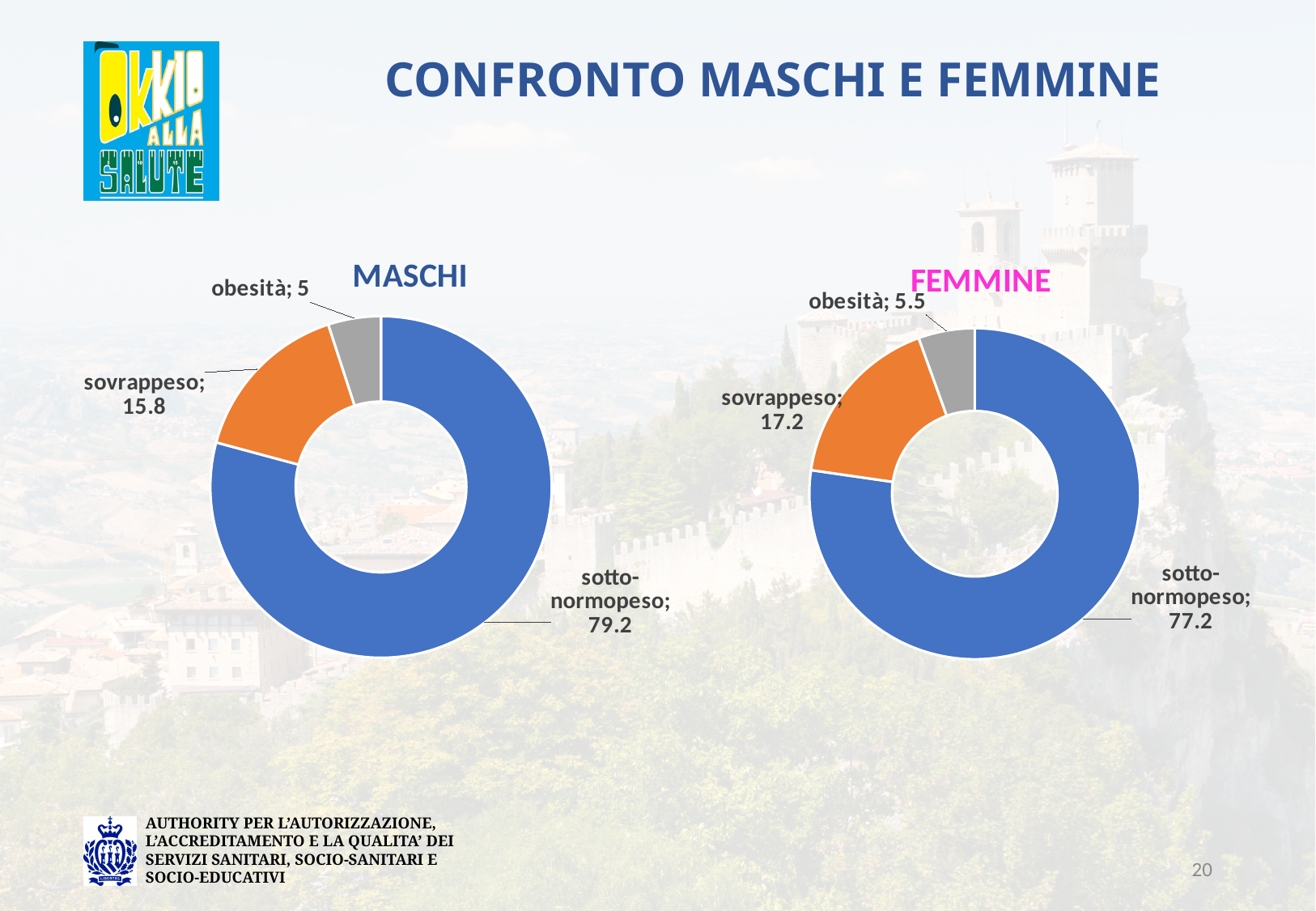
Which is larger: sotto-normopeso in the MASCHI chart or sotto-normopeso in the FEMMINE chart? MASCHI What is the difference between the sovrappeso values in the FEMMINE chart and the MASCHI chart? 1.4 In the FEMMINE chart, what is the value for sovrappeso? 17.2 In the MASCHI chart, which category has the smallest value? obesità What is the title of the slide? CONFRONTO MASCHI E FEMMINE In the FEMMINE chart, which category has the largest value? sotto-normopeso In the MASCHI chart, what is the value for sotto-normopeso? 79.2 How many categories does the MASCHI chart show? 3 In the MASCHI chart, what colour is the sovrappeso segment? orange In the FEMMINE chart, what is the value for obesità? 5.5 In the MASCHI chart, what is the value for obesità? 5 What kind of chart is the FEMMINE chart? doughnut chart